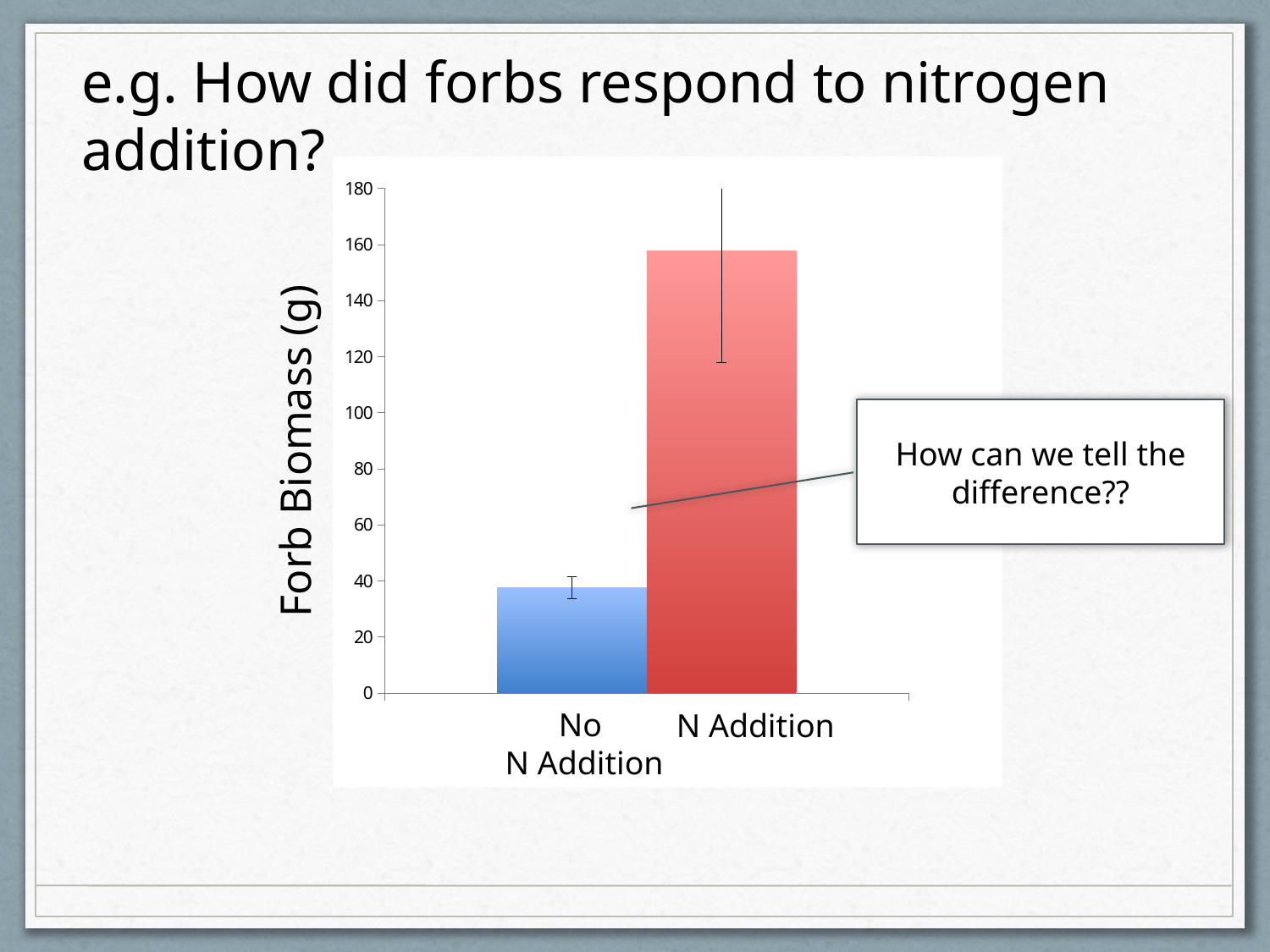
Is the value for N Addition greater or less than 140? greater What is the label on the y axis of the chart? Forb Biomass (g) Which category has the lower forb biomass? No N Addition What colour is the bar for N Addition? red Which category has the higher forb biomass? N Addition How many categories are plotted on the x axis? 2 Is the forb biomass larger for N Addition or for No N Addition? N Addition Is the value for N Addition greater or less than 180? less Is the value for No N Addition greater or less than 60? less What kind of chart is shown on the slide? bar chart